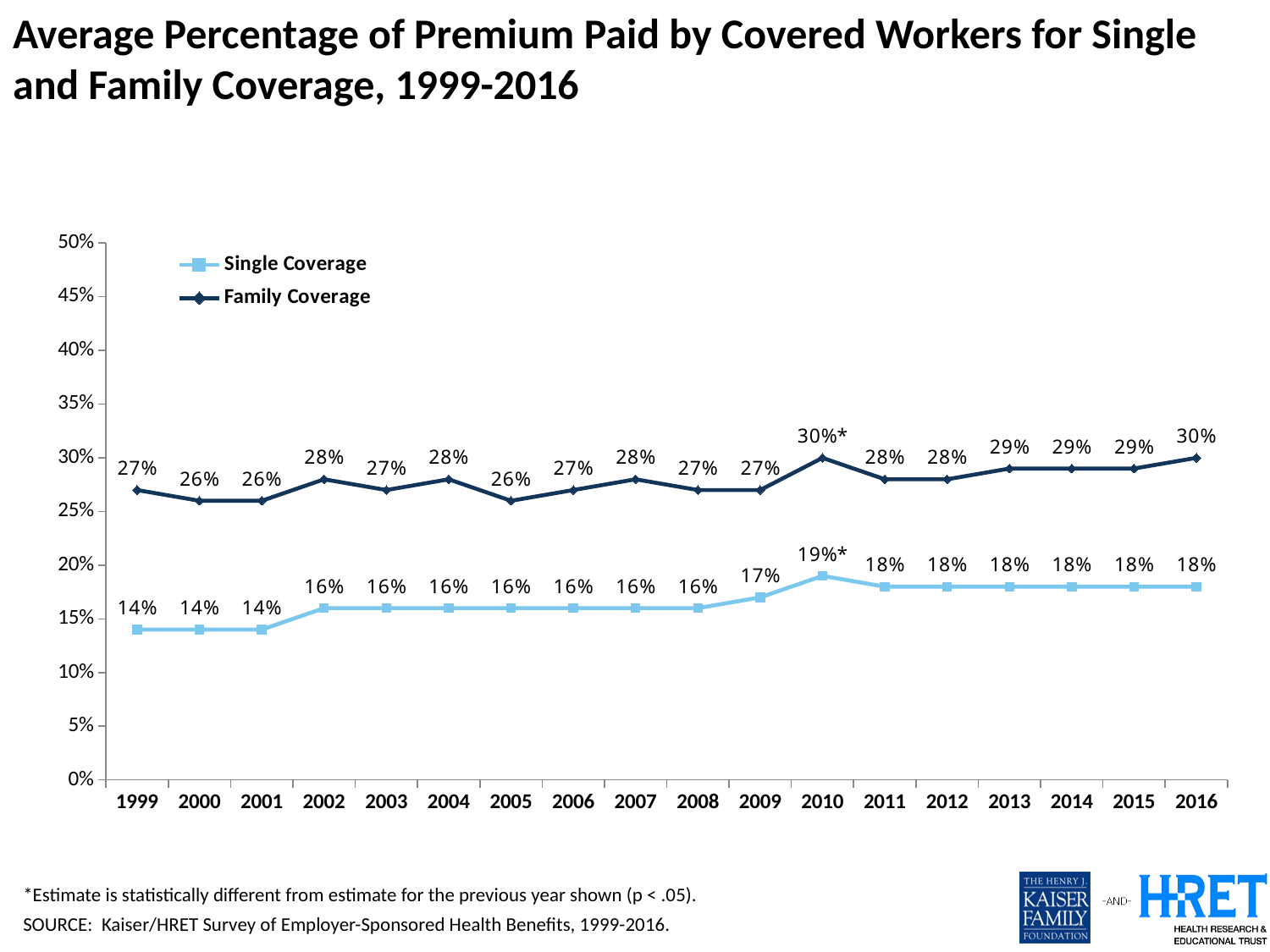
How many series does the legend list? 2 What was the Single Coverage value in 2010? 19%* What was the Family Coverage value in 2005? 26% How many years are shown on the x axis? 18 What is the difference between the Family Coverage and Single Coverage values in 2016? 12% Which series has the higher value in 2008, Single Coverage or Family Coverage? Family Coverage Is the Family Coverage value in 2010 greater or less than 25%? greater What was the average percentage of premium paid by covered workers for Family Coverage in 2016? 30% Does the Single Coverage series generally rise or fall from 1999 to 2016? Rise What is the difference between the Single Coverage value in 2016 and in 1999? 4% What was the average percentage of premium paid by covered workers for Single Coverage in 1999? 14% What kind of chart is shown on the slide? Line chart